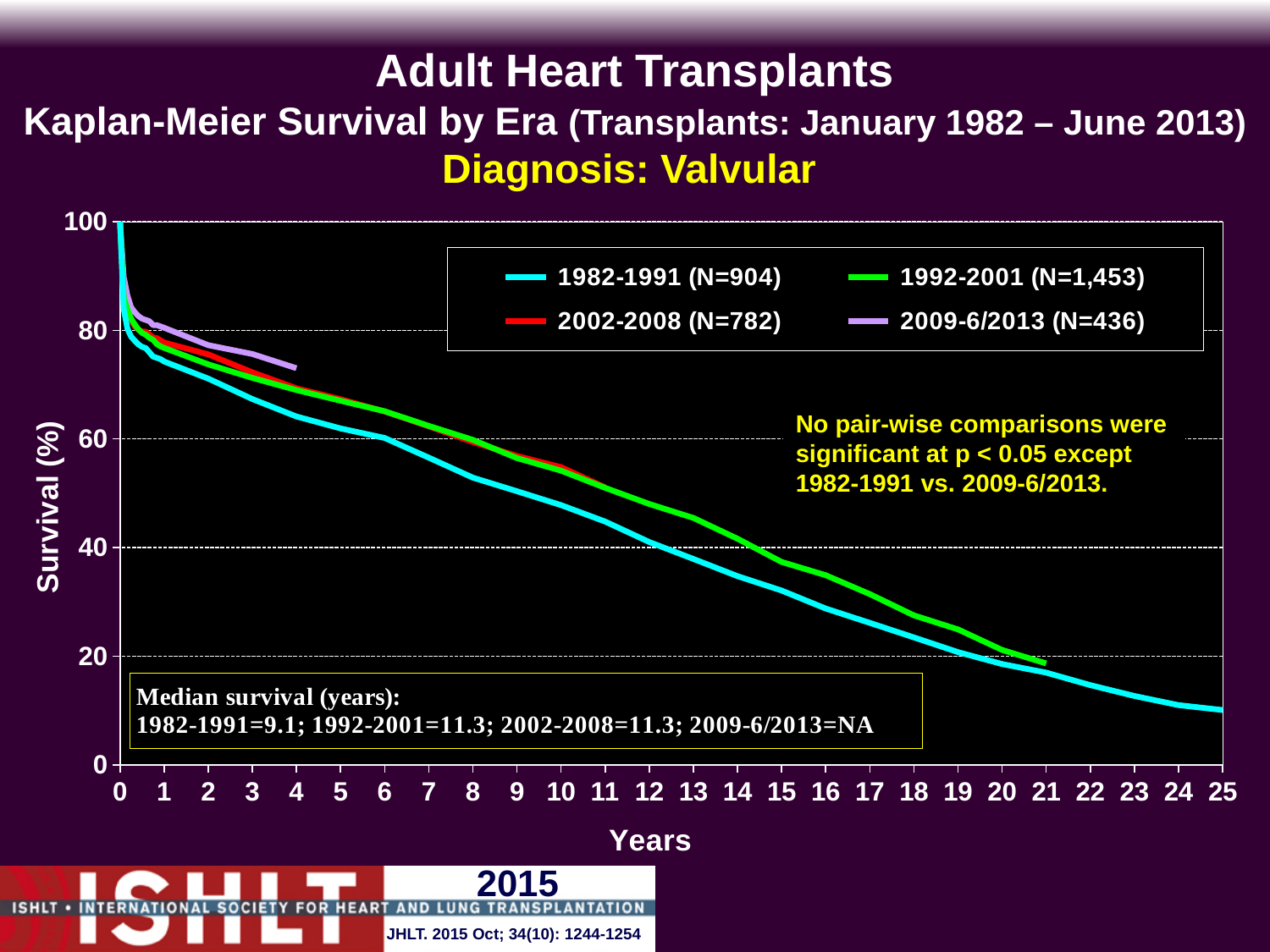
Is the survival for the 1992-2001 era at 5 years greater or less than 60? greater How many series does the legend list? 4 Do the survival curves rise or fall as years increase? fall What colour is the line for the 2002-2008 era? red What is the N for the 2002-2008 era shown in the legend? 782 What is the median survival for the 2009-6/2013 era? NA What kind of chart is shown on the slide? line chart At 10 years, which era has higher survival: 1982-1991 or 1992-2001? 1992-2001 What is the median survival in years for the 1982-1991 era? 9.1 Which era has the largest number of transplants (N) in the legend? 1992-2001 (N=1,453) What is the median survival in years for the 1992-2001 era? 11.3 Is the survival for the 1982-1991 era at 10 years greater or less than 60? less